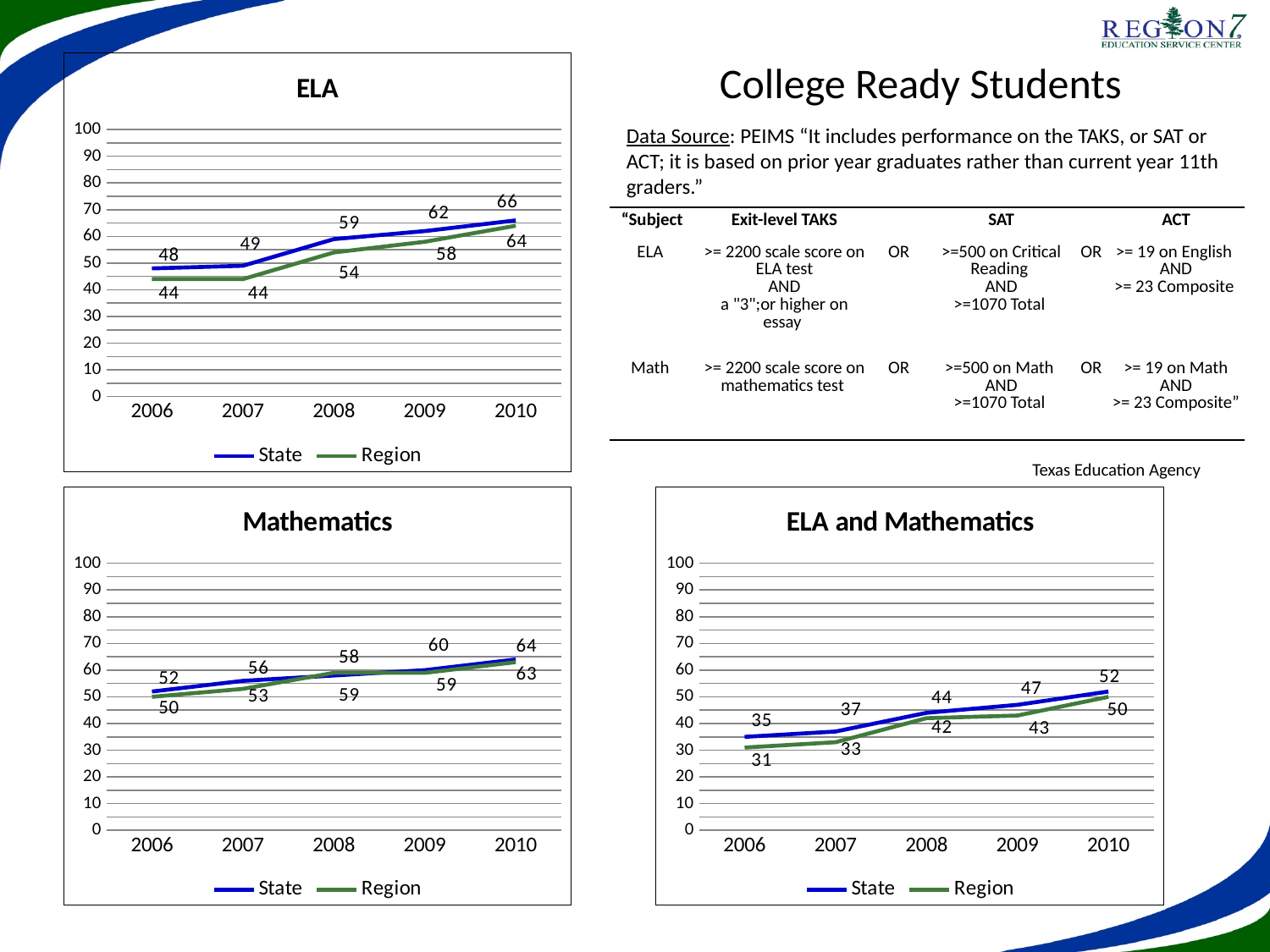
In the ELA and Mathematics chart, what is the State value for 2009? 47 In the ELA chart, what is the difference between the State and Region values in 2006? 4 How many series does the legend of the ELA chart list? 2 In the ELA chart, what is the Region value for 2008? 54 In the ELA and Mathematics chart, which year has the lowest Region value? 2006 In the Mathematics chart, which is larger in 2008, the State value or the Region value? Region In the ELA chart, what is the State value for 2010? 66 In the Mathematics chart, which year has the highest State value? 2010 In the Mathematics chart, what is the Region value for 2007? 53 In the ELA and Mathematics chart, does the Region value rise or fall from 2006 to 2010? Rise What type of chart is the Mathematics chart? Line chart In the ELA and Mathematics chart, what is the difference between the State values for 2010 and 2006? 17